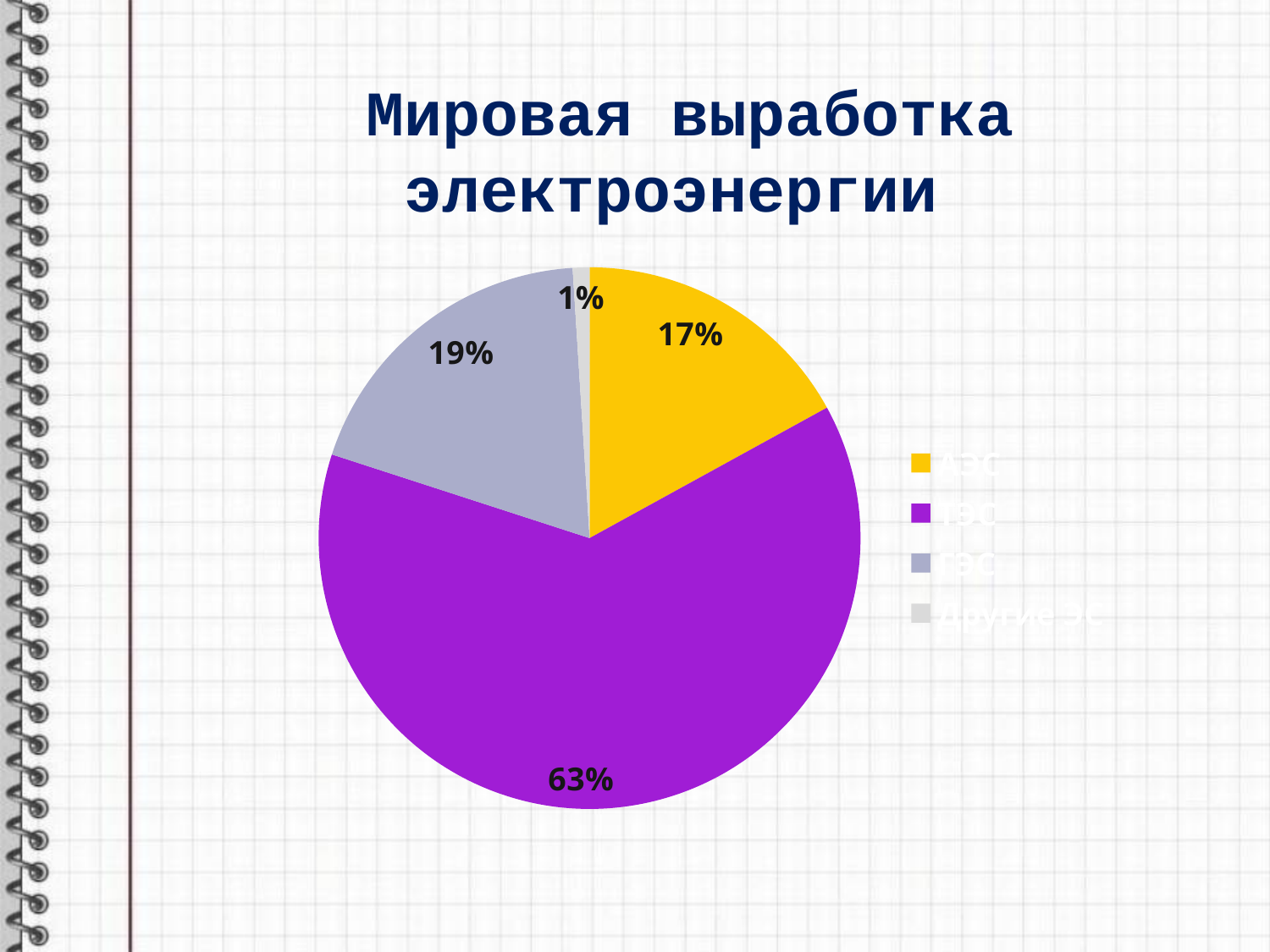
Which slice is larger, the yellow one or the grey-blue one? the grey-blue one What is the largest share shown in the pie chart? 63% How many entries does the legend list? 4 What kind of chart is shown on the slide? pie chart What share does the grey-blue slice represent? 19% How many slices does the pie chart have? 4 What is the difference between the grey-blue slice's share and the yellow slice's share? 2% What share does the yellow slice represent? 17% What is the difference between the purple slice's share and the grey-blue slice's share? 44% What share does the purple slice represent? 63% What is the title of the chart? Мировая выработка электроэнергии What is the smallest share shown in the pie chart? 1%